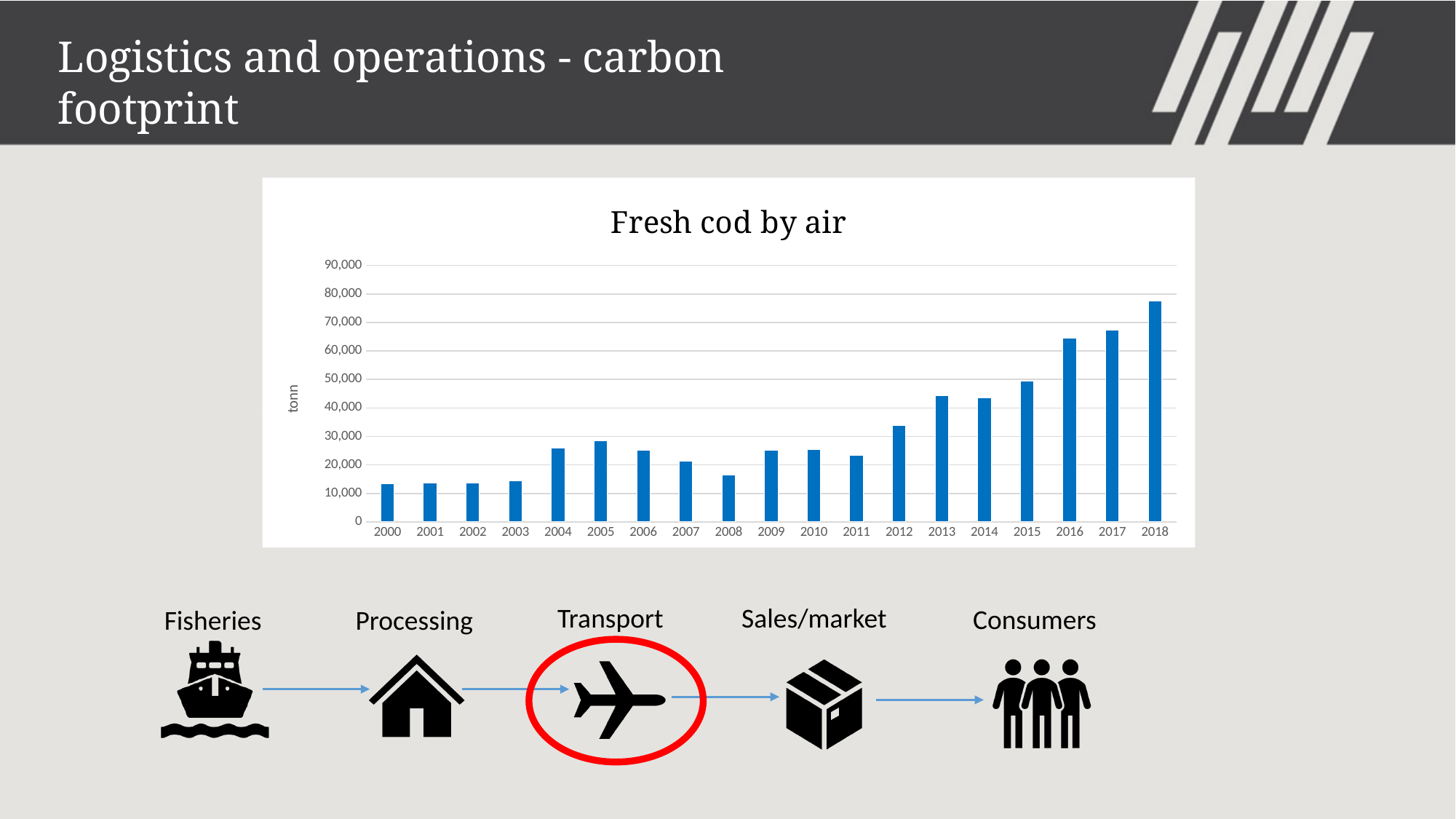
Which is larger, the value for 2012 or the value for 2016? 2016 What is the label on the vertical axis of the chart? tonn What is the title of the chart? Fresh cod by air How many years are shown on the x axis of the chart? 19 Is the value for 2000 greater or less than 20,000? less Is the value for 2018 greater or less than 70,000? greater Is the value for 2013 greater or less than 40,000? greater What kind of chart is shown on the slide? bar chart Overall, do the values rise or fall from 2000 to 2018? rise Which is larger, the value for 2005 or the value for 2008? 2005 Which year has the highest value in the chart? 2018